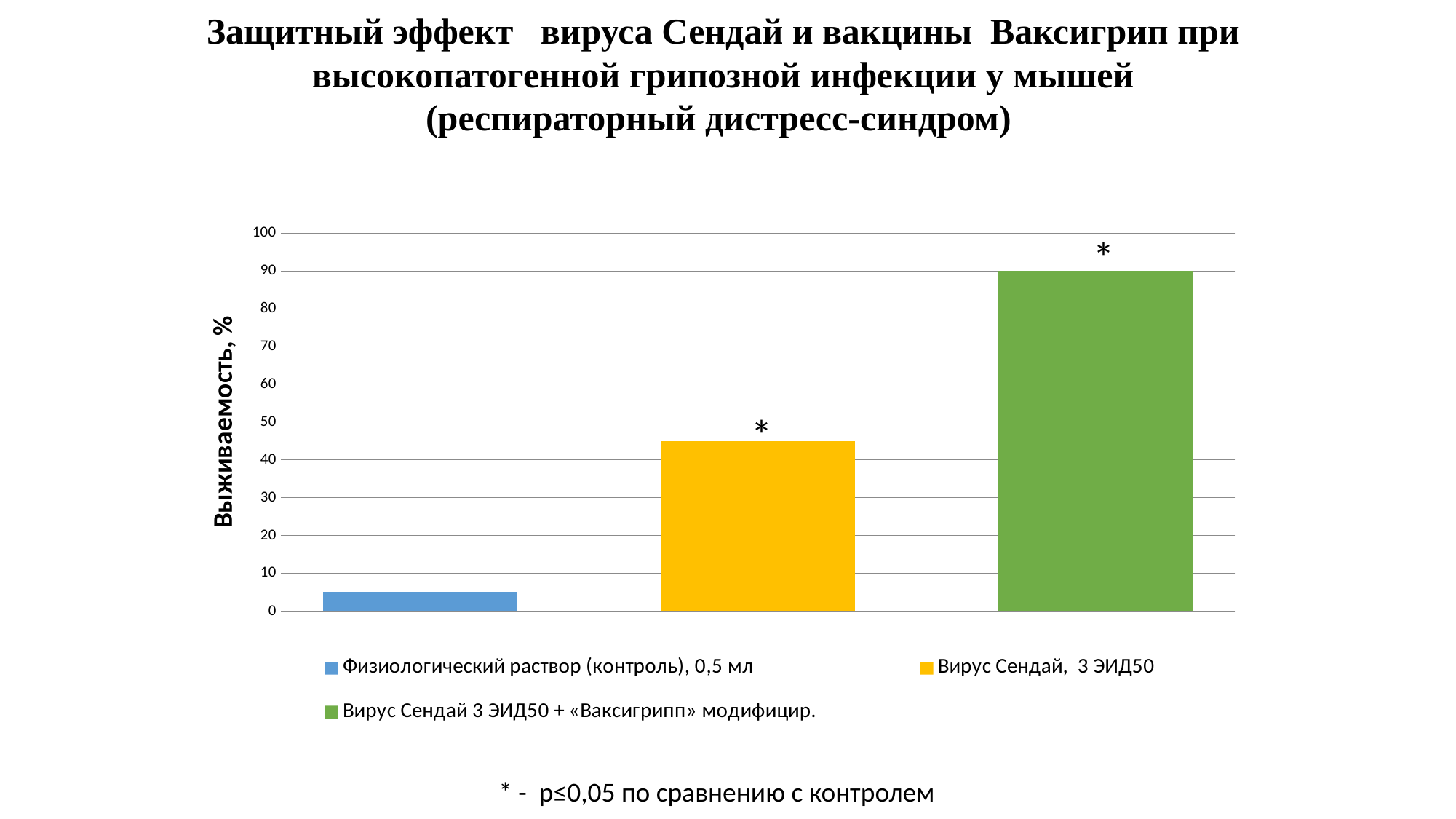
Is the value for Вирус Сендай, 3 ЭИД50 greater or less than 40? greater How many bars are plotted in the chart? 3 Which is larger: the value for Вирус Сендай, 3 ЭИД50 or the value for Физиологический раствор (контроль), 0,5 мл? Вирус Сендай, 3 ЭИД50 How many series does the legend list? 3 Which series has the highest survival rate? Вирус Сендай 3 ЭИД50 + «Ваксигрипп» модифицир. Is the value for Вирус Сендай, 3 ЭИД50 greater or less than 50? less What colour is the bar for Вирус Сендай, 3 ЭИД50? yellow What is the label of the vertical axis? Выживаемость, % What kind of chart is shown on the slide? bar chart Is the value for Вирус Сендай 3 ЭИД50 + «Ваксигрипп» модифицир. greater or less than 80? greater Which series has the lowest survival rate? Физиологический раствор (контроль), 0,5 мл